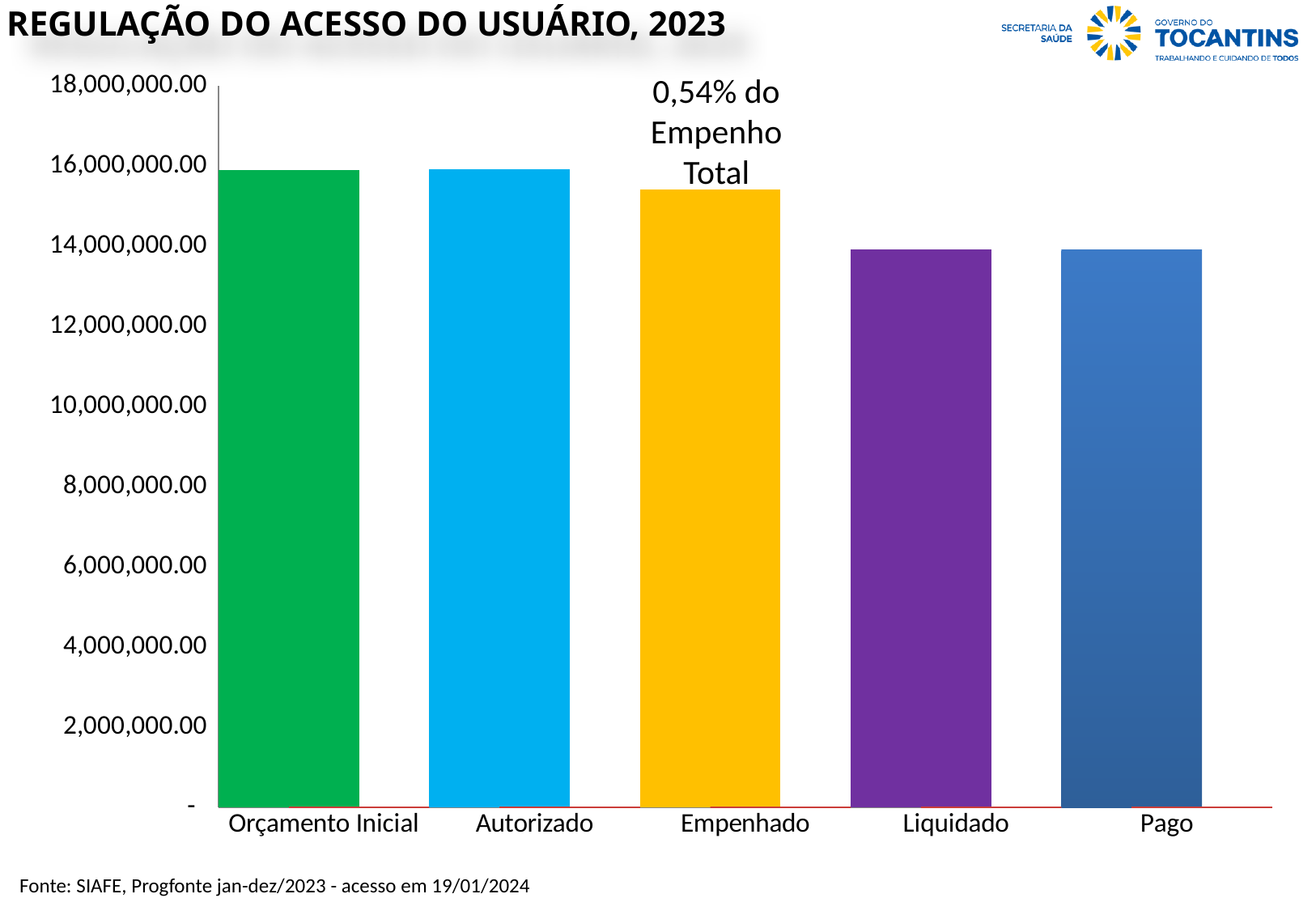
Is the value for Pago greater or less than 12,000,000.00? greater Do the values generally rise or fall from Orçamento Inicial to Pago along the x axis? fall Is the value for Orçamento Inicial greater or less than 14,000,000.00? greater What kind of chart is shown on the slide? bar chart What text is written above the Empenhado bar? 0,54% do Empenho Total Is the value for Empenhado greater or less than 16,000,000.00? less How many categories are shown on the x axis of the chart? 5 What is the title of the chart? REGULAÇÃO DO ACESSO DO USUÁRIO, 2023 Which is larger, the value for Autorizado or the value for Empenhado? Autorizado Which is larger, the value for Empenhado or the value for Liquidado? Empenhado